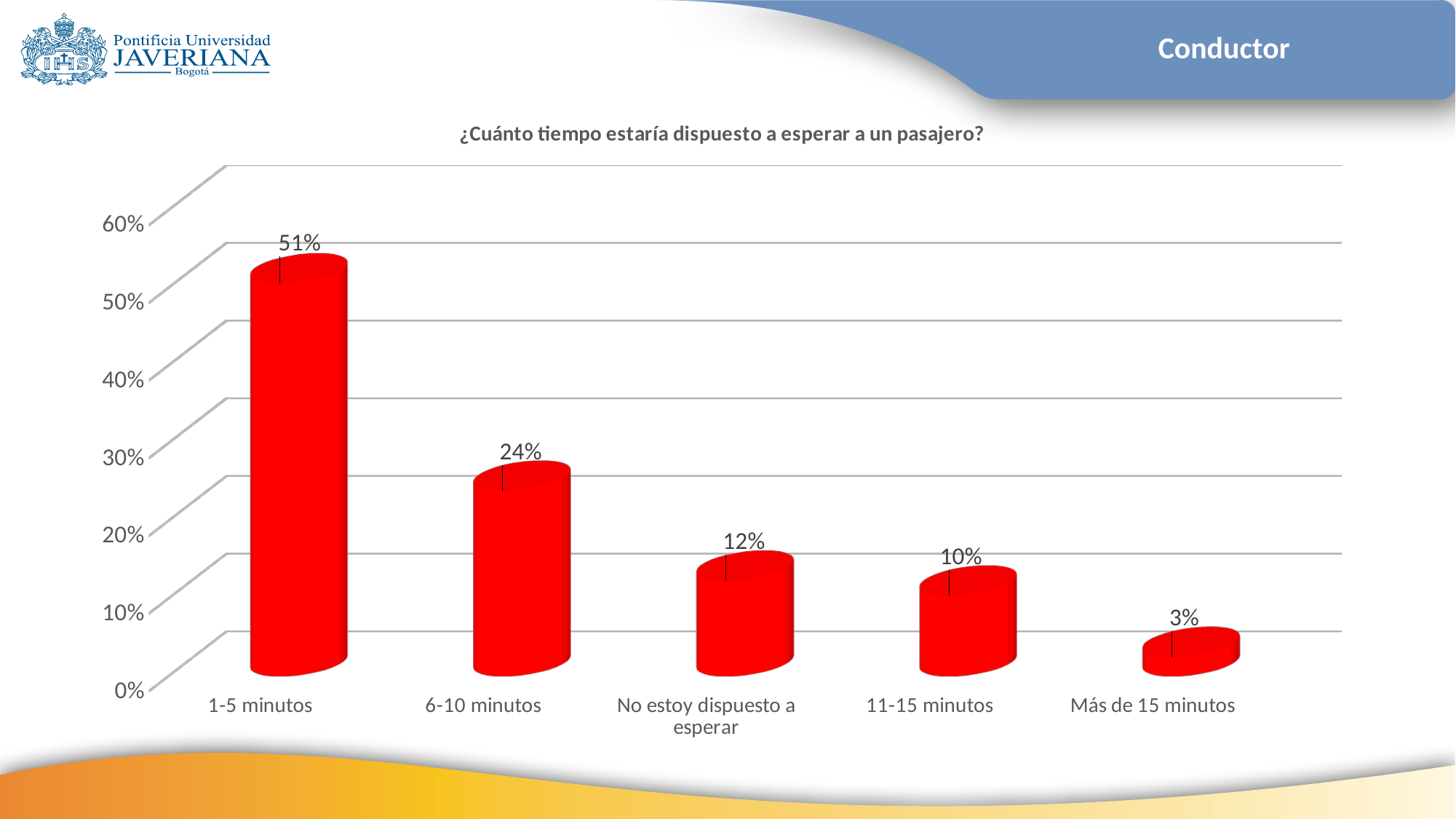
Which category has the lowest value? Más de 15 minutos What is the value for No estoy dispuesto a esperar? 12% Is the value for 6-10 minutos greater or less than 20%? greater What is the value for 6-10 minutos? 24% Which category has the highest value? 1-5 minutos How many categories are shown on the x axis? 5 What is the value for Más de 15 minutos? 3% What is the title of the chart? ¿Cuánto tiempo estaría dispuesto a esperar a un pasajero? Which is larger, the value for 11-15 minutos or the value for No estoy dispuesto a esperar? No estoy dispuesto a esperar What is the value for 1-5 minutos? 51% What is the difference between the values for 1-5 minutos and 6-10 minutos? 27% What kind of chart is shown on the slide? bar chart